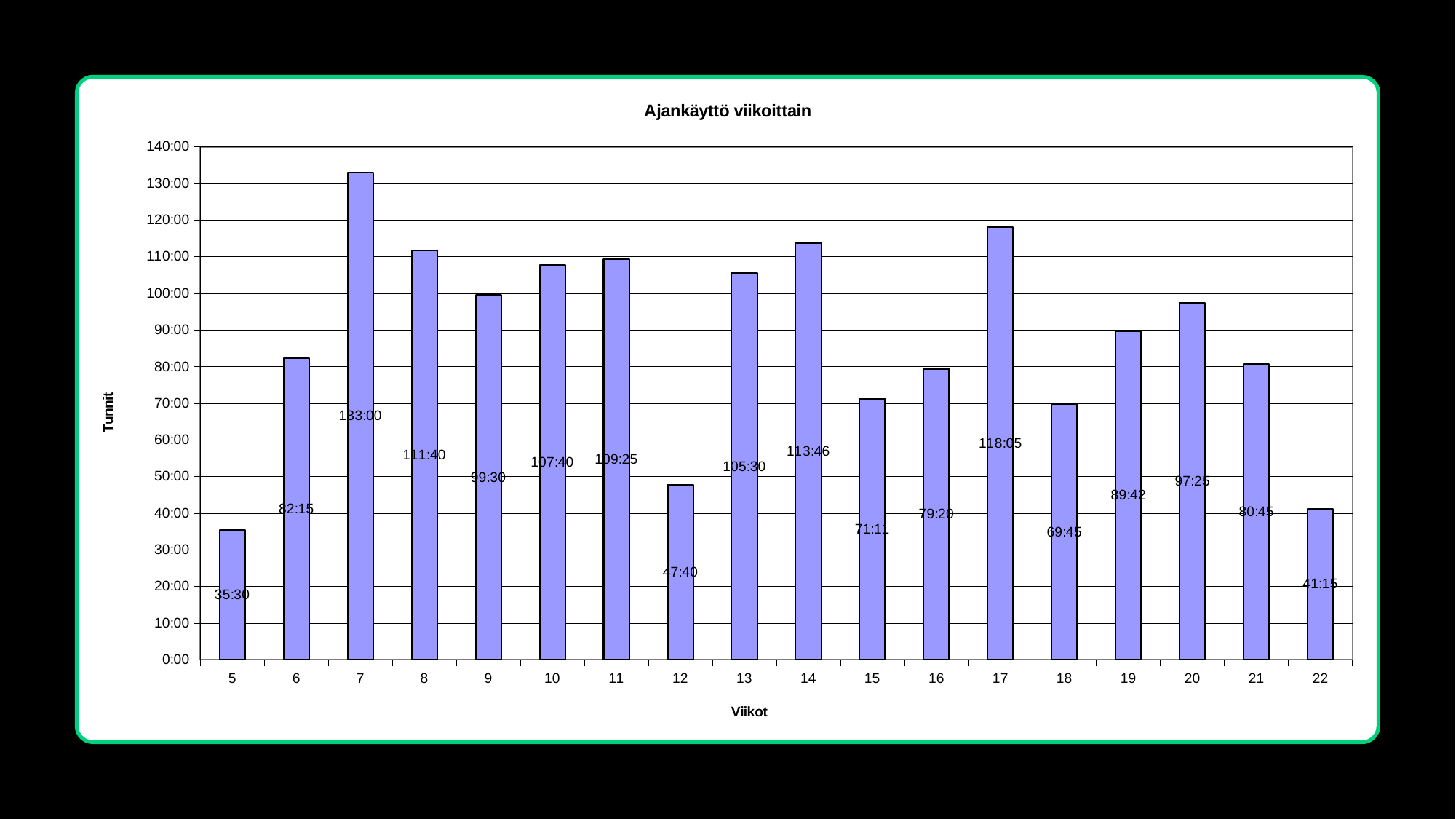
What is the value for week 7? 133:00 How many weeks are plotted on the x axis? 18 What is the difference between the values for week 7 and week 5? 97:30 Which week has the lowest value? 5 What kind of chart is shown on the slide? bar chart What is the value for week 14? 113:46 Is the value for week 20 greater or less than 90:00? greater What is the title of the chart? Ajankäyttö viikoittain Which is larger, the value for week 10 or the value for week 11? week 11 What is the label of the y axis? Tunnit Which week has the highest value? 7 What is the value for week 22? 41:15